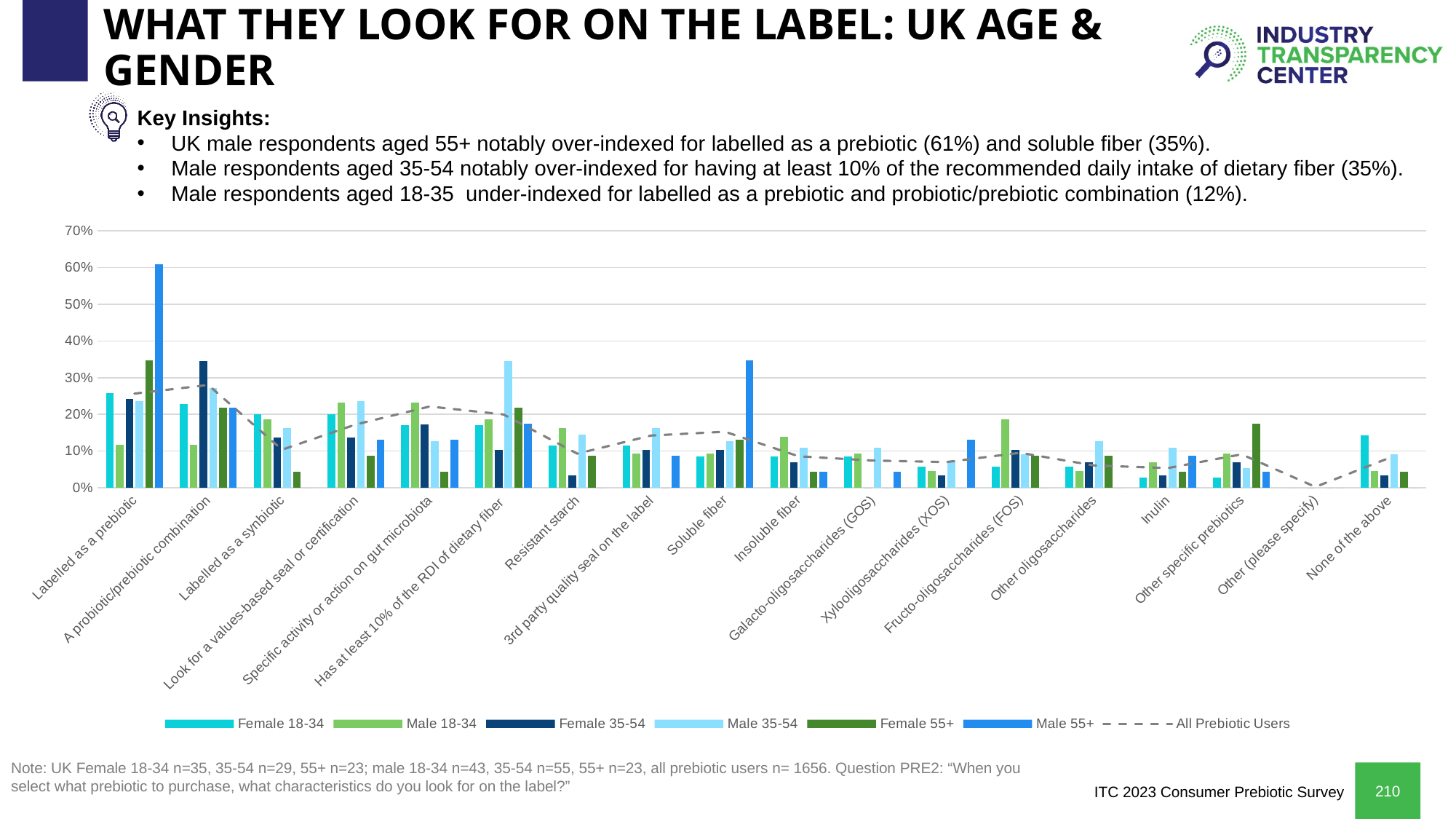
Is the Male 55+ value for 'Soluble fiber' greater or less than 30%? greater Which series has the tallest bar for 'Labelled as a prebiotic'? Male 55+ What kind of chart is shown on the slide? combination bar and line chart Is the Female 55+ value for 'Labelled as a synbiotic' greater or less than 10%? less Is the Male 55+ value for 'Labelled as a prebiotic' greater or less than 50%? greater Which category contains the tallest bar in the whole chart? Labelled as a prebiotic Which is larger for Male 55+: the value for 'Labelled as a prebiotic' or the value for 'Soluble fiber'? Labelled as a prebiotic How many categories are shown along the x axis of the chart? 18 What does the dashed grey line in the chart represent? All Prebiotic Users How many series does the chart legend list? 7